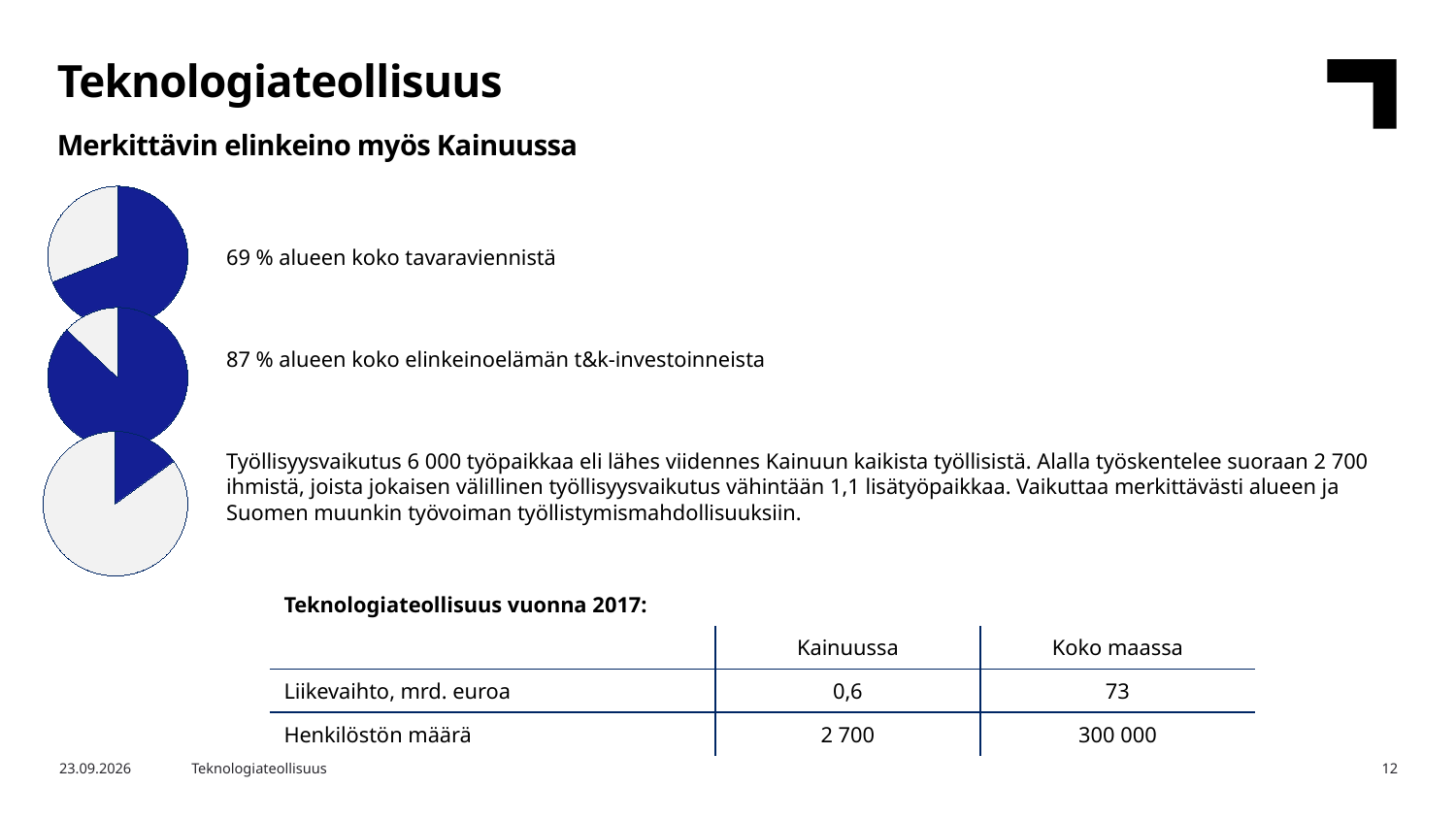
Is the blue slice in the top pie chart greater or less than 50 %? greater Which of the three pie charts has the smallest blue slice? The bottom pie chart How many slices does each pie chart have? 2 What does the blue slice of the top pie chart represent according to the text next to it? 69 % alueen koko tavaraviennistä Which of the three pie charts has the largest blue slice? The middle pie chart (87 %) In the middle pie chart, what share does the blue slice represent? 87 % Is the blue slice in the bottom pie chart greater or less than 50 %? less What kind of charts are shown on the left side of the slide? Pie charts In the top pie chart, what share does the blue slice represent? 69 % What colour is the highlighted slice in the pie charts? Blue Which is larger: the blue slice in the top pie chart or the blue slice in the middle pie chart? The middle pie chart How many pie charts are on the slide? 3